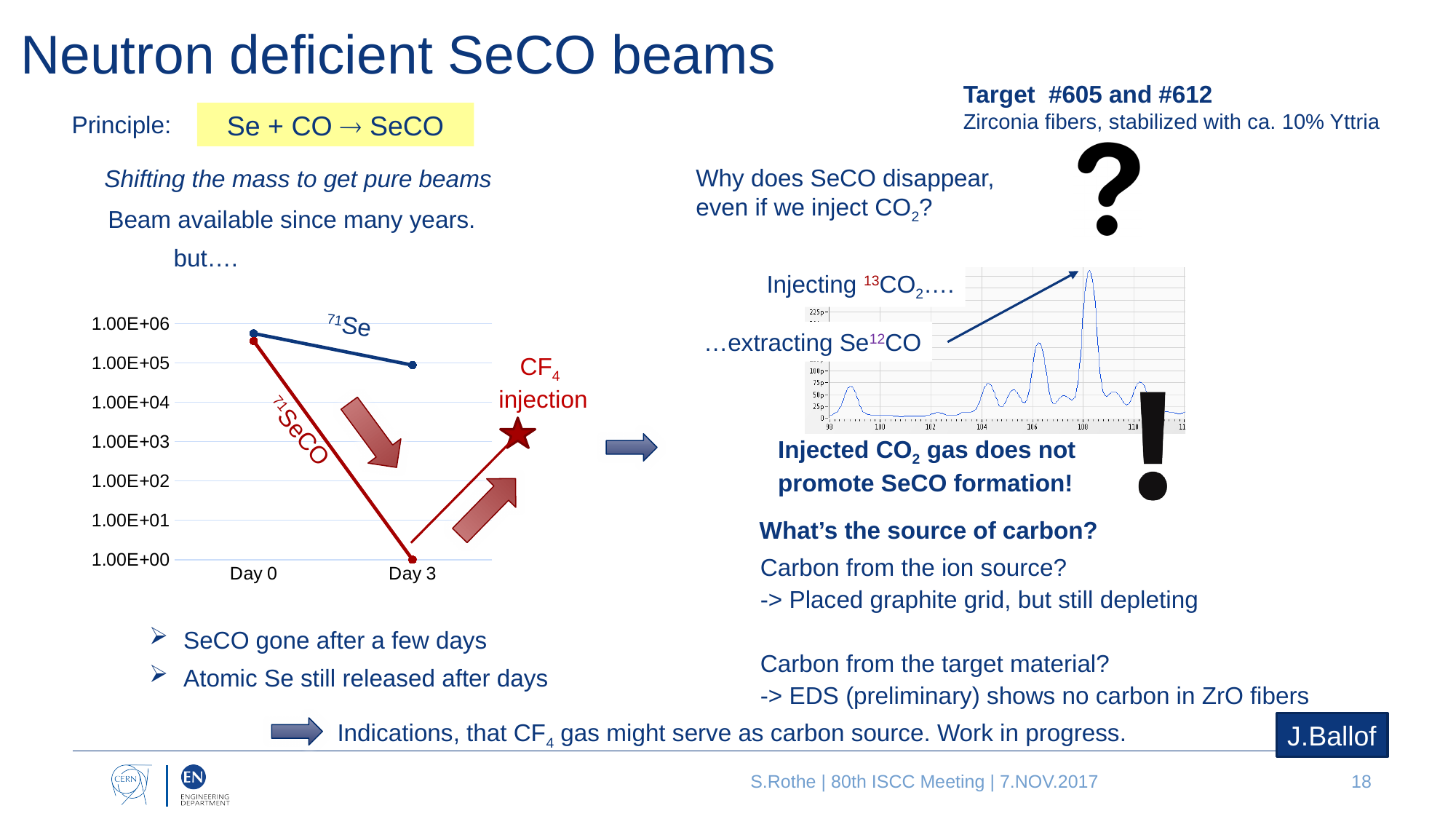
What are the x-axis categories of the chart on the left? Day 0 and Day 3 In the chart on the left, which series has the higher value at Day 3, 71Se or 71SeCO? 71Se What kind of chart is shown on the left of the slide? line chart In the chart on the left, does the 71SeCO series rise or fall from Day 0 to Day 3? fall In the chart on the left, is the value for 71SeCO at Day 3 greater or less than 1.00E+01? less How many x-axis categories does the chart on the left have? 2 In the chart on the left, which series drops more steeply between Day 0 and Day 3? 71SeCO How many data series are plotted in the chart on the left? 2 In the chart on the left, is the value for 71Se at Day 0 greater or less than 1.00E+05? greater In the chart on the left, does the 71Se series rise or fall from Day 0 to Day 3? fall In the chart on the left, is the value for 71SeCO at Day 0 greater or less than 1.00E+04? greater What is the highest y-axis tick label on the chart on the left? 1.00E+06